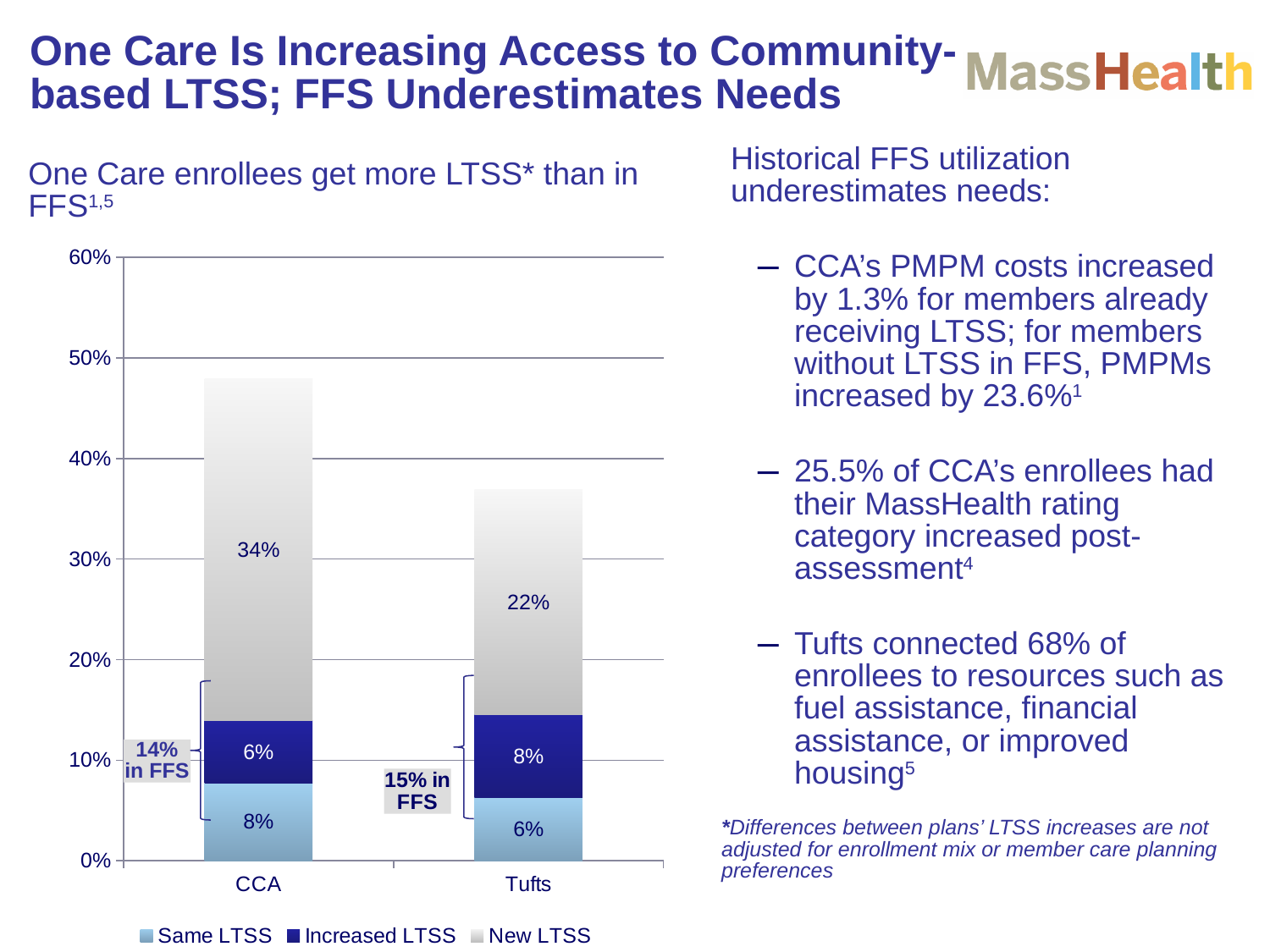
How many categories are plotted on the x axis of the chart? 2 What is the New LTSS value for CCA? 34% What is the total of the stacked bar for CCA? 48% What kind of chart is shown on the slide? Stacked bar chart Which category has the larger New LTSS value, CCA or Tufts? CCA How many series does the chart legend list? 3 What is the total of the stacked bar for Tufts? 36% Which series is shown in the darkest blue colour in the chart? Increased LTSS What is the New LTSS value for Tufts? 22% What is the Increased LTSS value for Tufts? 8% What is the Same LTSS value for CCA? 8% What is the difference between the New LTSS values for CCA and Tufts? 12%